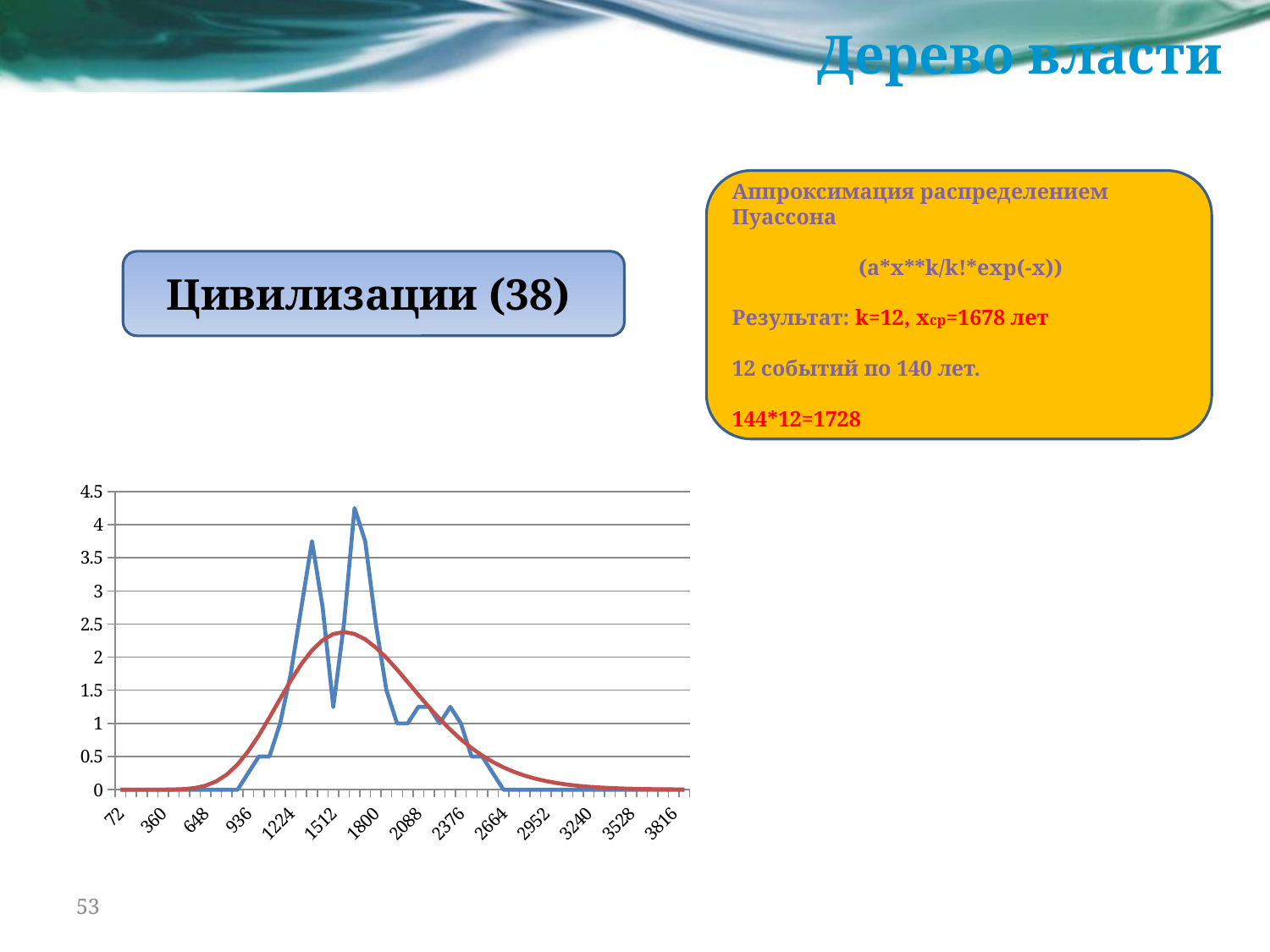
Is the peak value of the red curve greater or less than 3? less Which line reaches a higher peak, the blue line or the red curve? the blue line What is the highest tick value shown on the y axis of the chart? 4.5 Is the peak value of the blue line near 1800 greater or less than 4? greater What kind of chart is shown on the slide? line chart Does the red curve rise or fall between 2088 and 3816 on the x axis? falls Is the value of the blue line at its dip near 1512 greater or less than 1.5? less What is the first label on the x axis of the chart? 72 How many lines are plotted on the chart? 2 How many labels are printed along the x axis of the chart? 14